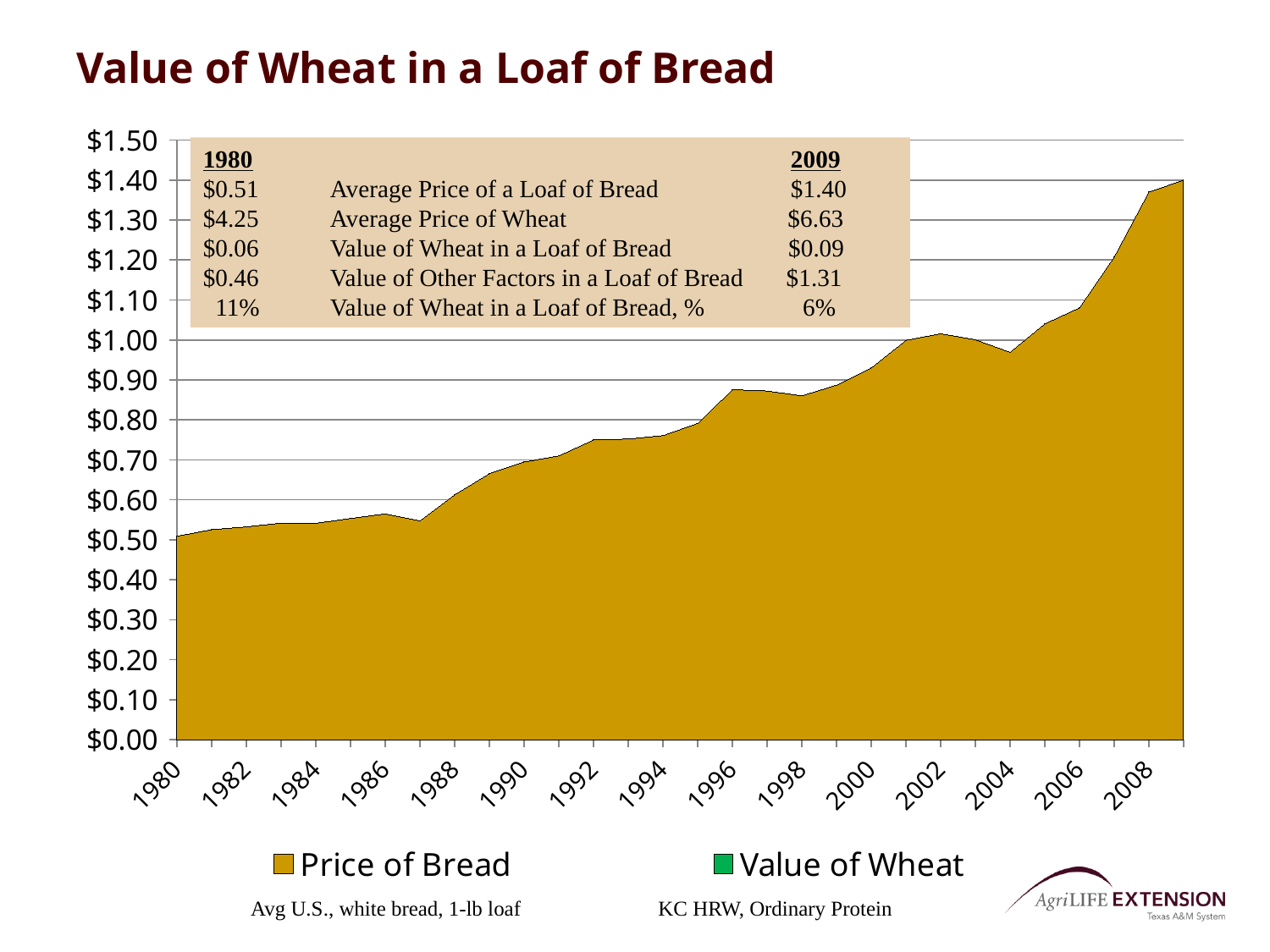
In which year is the price of bread highest? 2009 By how much did the average price of a loaf of bread increase from 1980 to 2009? $0.89 What kind of chart is shown on the slide? area chart Does the price of bread generally rise or fall from 1980 to 2009? rise In which year is the price of bread lowest? 1980 What is the average price of a loaf of bread in 2009? $1.40 What is the average price of a loaf of bread in 1980? $0.51 Is the price of bread in 1996 greater or less than $0.80? greater Is the price of bread in 2006 greater or less than $1.00? greater How many series does the legend list? 2 Which series is shown in gold on the chart? Price of Bread What is the title of the chart? Value of Wheat in a Loaf of Bread